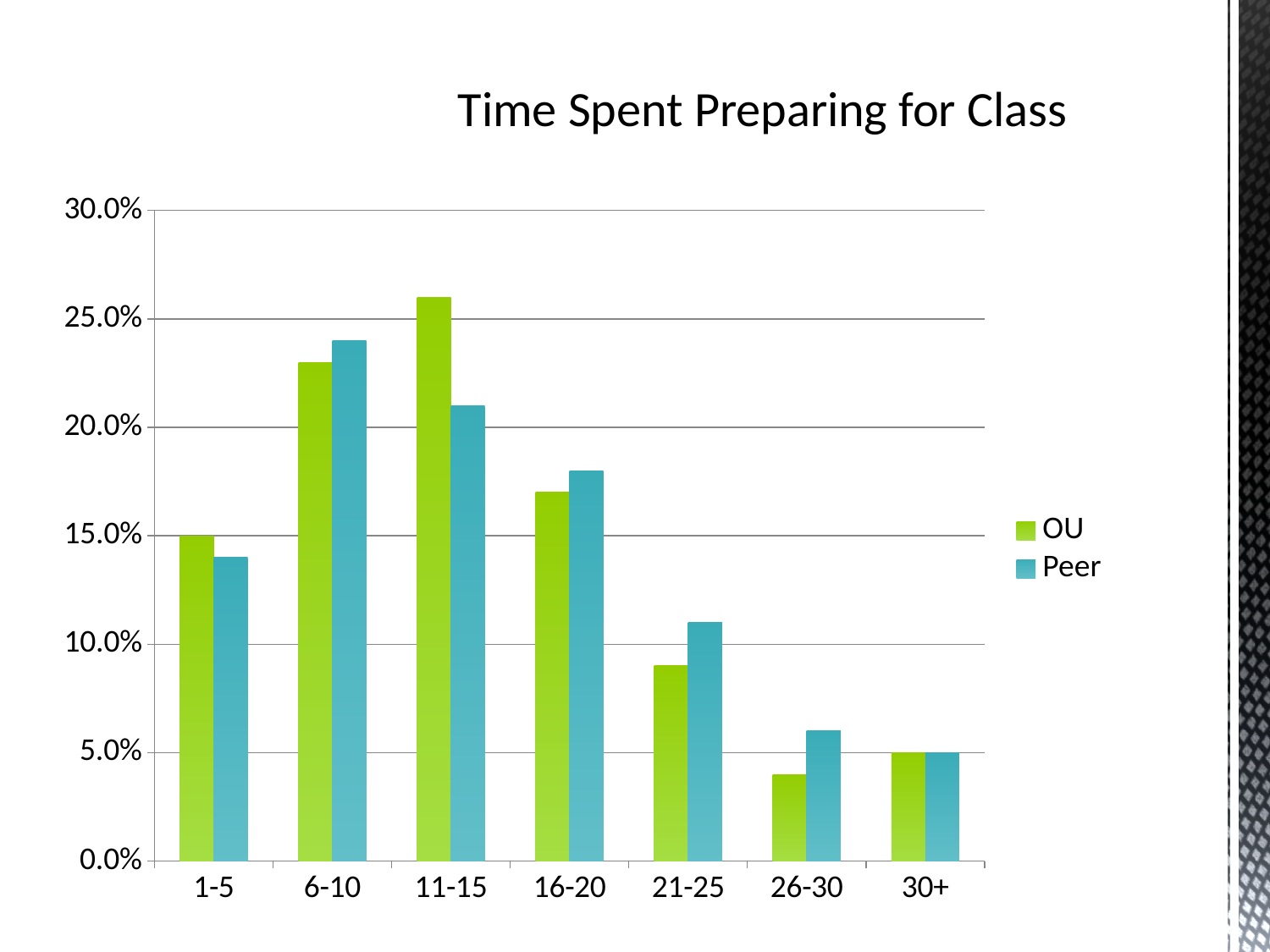
How many series does the legend list? 2 Which category has the lowest OU value? 26-30 What is the title of the chart? Time Spent Preparing for Class What is the Peer value for the 30+ category? 5.0% For the 11-15 category, which series has the larger value, OU or Peer? OU Which category has the highest Peer value? 6-10 Which category has the highest OU value? 11-15 Is the Peer value for 21-25 greater or less than 10.0%? greater Is the OU value for 6-10 greater or less than 25.0%? less How many categories are shown on the x axis? 7 What is the OU value for the 1-5 category? 15.0% What type of chart is shown on the slide? bar chart